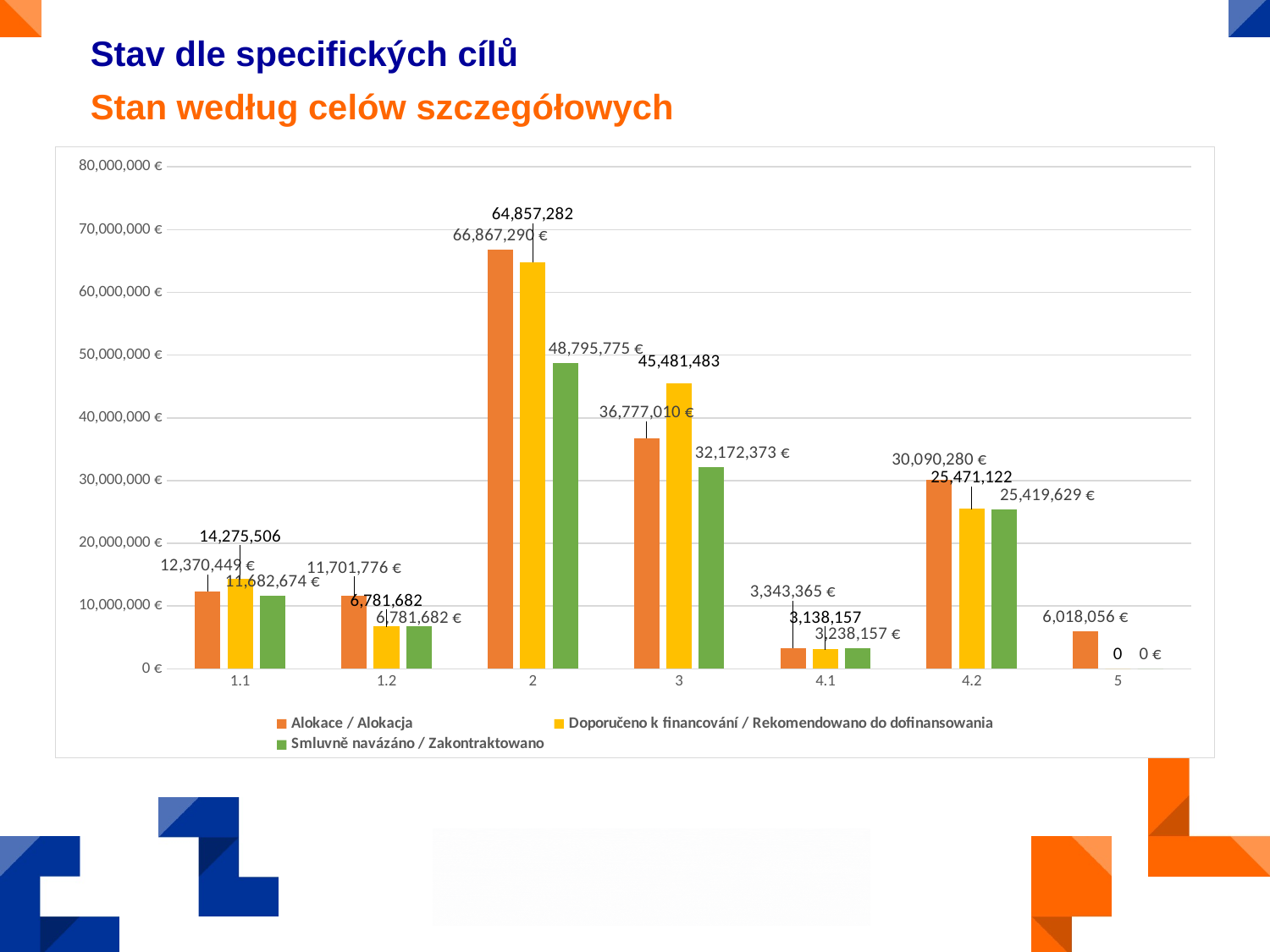
Which category has the lowest Smluvně navázáno / Zakontraktowano value? 5 Is the Smluvně navázáno / Zakontraktowano value for category 2 greater or less than 40,000,000 €? greater How many series does the legend list? 3 What is the Alokace / Alokacja value for category 2? 66,867,290 € For category 3, which is larger: the Alokace / Alokacja value or the Doporučeno k financování / Rekomendowano do dofinansowania value? Doporučeno k financování / Rekomendowano do dofinansowania What is the Doporučeno k financování / Rekomendowano do dofinansowania value for category 3? 45,481,483 What is the Smluvně navázáno / Zakontraktowano value for category 4.2? 25,419,629 € What is the difference between the Alokace / Alokacja and Smluvně navázáno / Zakontraktowano values for category 1.2? 4,920,094 € What is the Alokace / Alokacja value for category 5? 6,018,056 € How many categories are shown on the x axis? 7 Which category has the highest Alokace / Alokacja value? 2 What kind of chart is shown on the slide? Bar chart